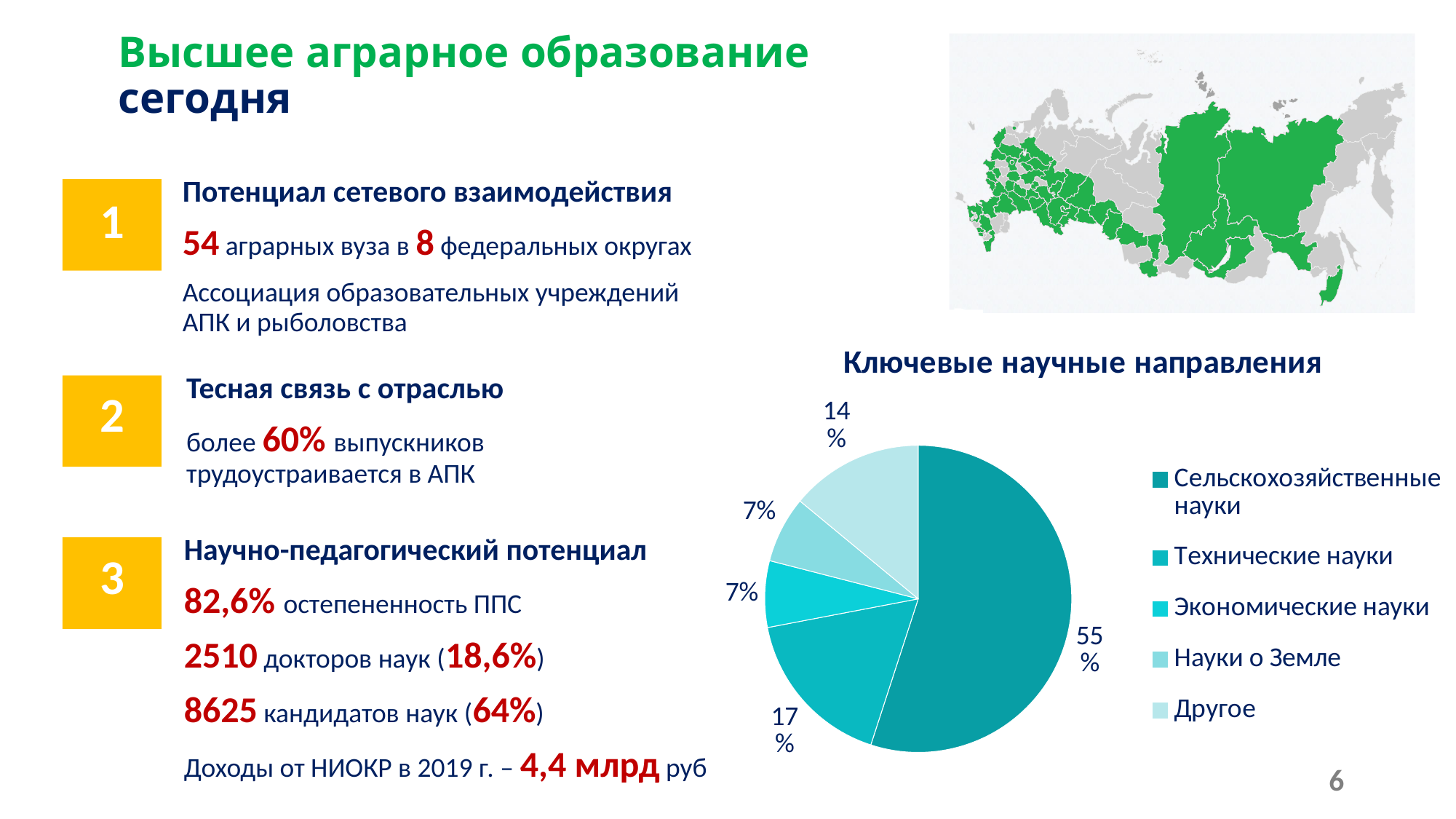
Какая категория имеет наибольшую долю на диаграмме «Ключевые научные направления»? Сельскохозяйственные науки Как называется диаграмма на слайде? Ключевые научные направления На сколько процентных пунктов доля «Сельскохозяйственных наук» больше доли «Технических наук» на диаграмме «Ключевые научные направления»? 38 Сколько категорий показано в легенде диаграммы «Ключевые научные направления»? 5 Какой тип диаграммы показан на слайде под заголовком «Ключевые научные направления»? Круговая диаграмма Что больше на диаграмме «Ключевые научные направления»: доля «Технических наук» или доля «Другое»? Технические науки Какую долю занимает категория «Другое» на диаграмме «Ключевые научные направления»? 14% На сколько процентных пунктов доля «Другое» больше доли «Науки о Земле» на диаграмме «Ключевые научные направления»? 7 Какую долю занимают «Сельскохозяйственные науки» на диаграмме «Ключевые научные направления»? 55% Какую долю занимают «Экономические науки» на диаграмме «Ключевые научные направления»? 7% Какая категория указана последней в легенде диаграммы «Ключевые научные направления»? Другое Какую долю занимают «Технические науки» на диаграмме «Ключевые научные направления»? 17%